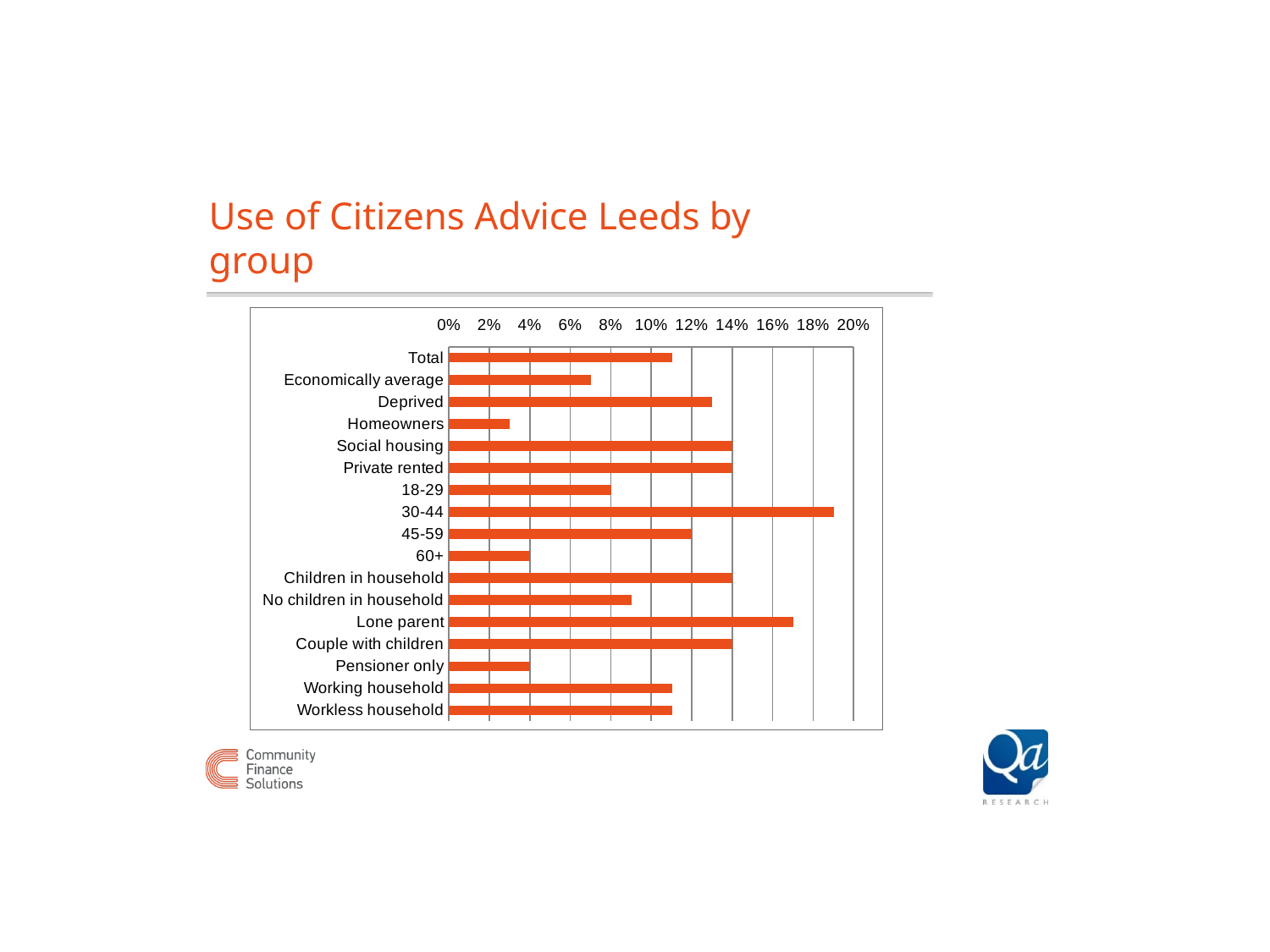
What is the title of the slide containing the chart? Use of Citizens Advice Leeds by group Which is larger, the value for Lone parent or the value for Deprived? Lone parent Which group has the highest value in the chart? 30-44 Is the value for Lone parent greater or less than 16%? greater Is the value for 30-44 greater or less than 18%? greater Is the value for Deprived greater or less than 12%? greater Which group has the lowest value in the chart? Homeowners Which is larger, the value for Children in household or the value for No children in household? Children in household What kind of chart is shown on the slide? bar chart How many groups (categories) are plotted in the chart? 17